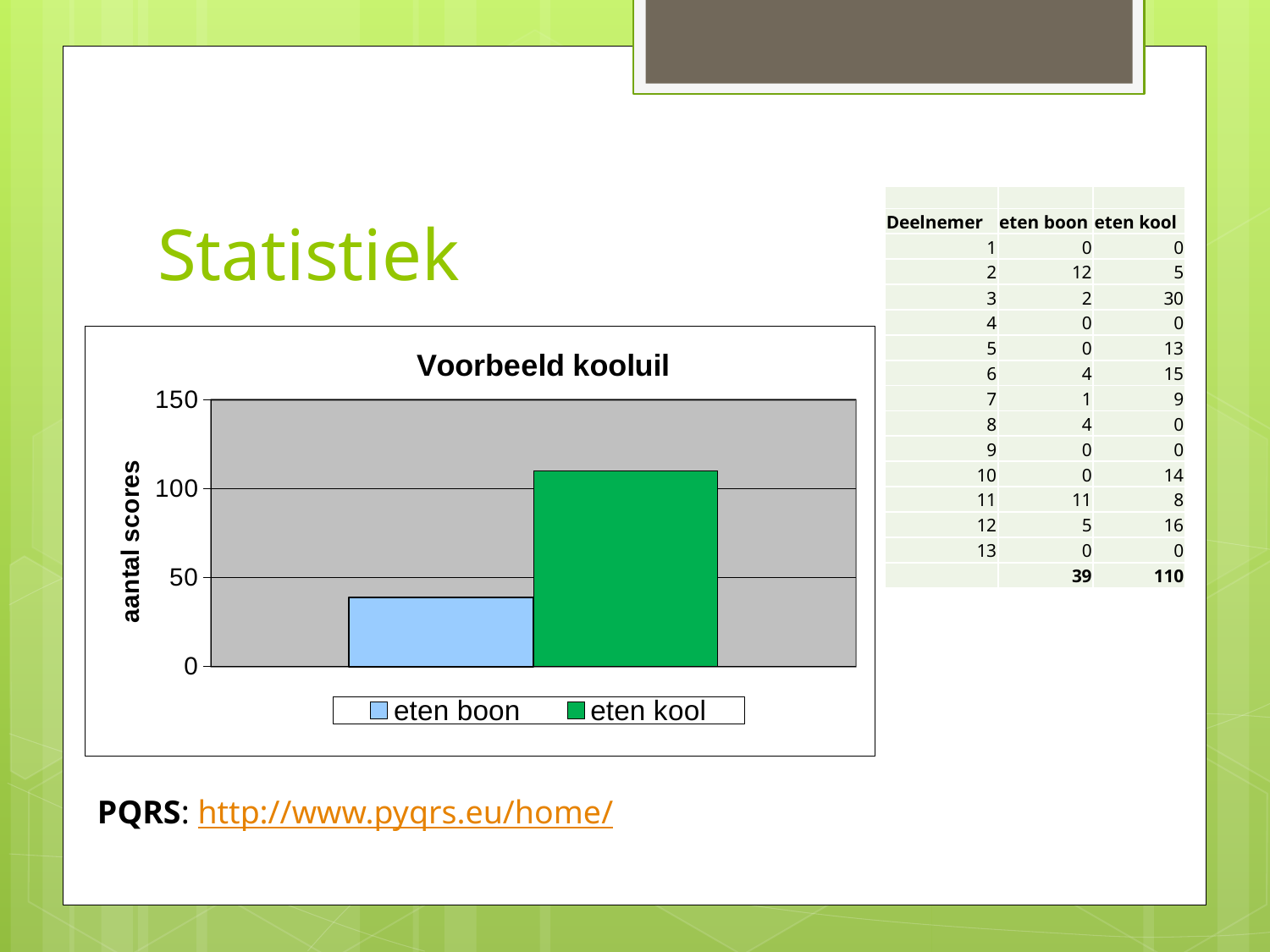
How many bars are plotted in the chart? 2 According to the totals in the table next to the chart, what is the value plotted for eten kool? 110 What is the label of the y axis of the chart? aantal scores Is the bar for eten kool greater or less than 100? greater What is the title of the chart? Voorbeeld kooluil Which series has the lowest bar in the chart? eten boon Which series has the highest bar in the chart? eten kool How many series does the chart legend list? 2 Is the bar for eten kool greater or less than 150? less What kind of chart is shown on the slide? bar chart Which is larger in the chart, the bar for eten boon or the bar for eten kool? eten kool Is the bar for eten boon greater or less than 50? less